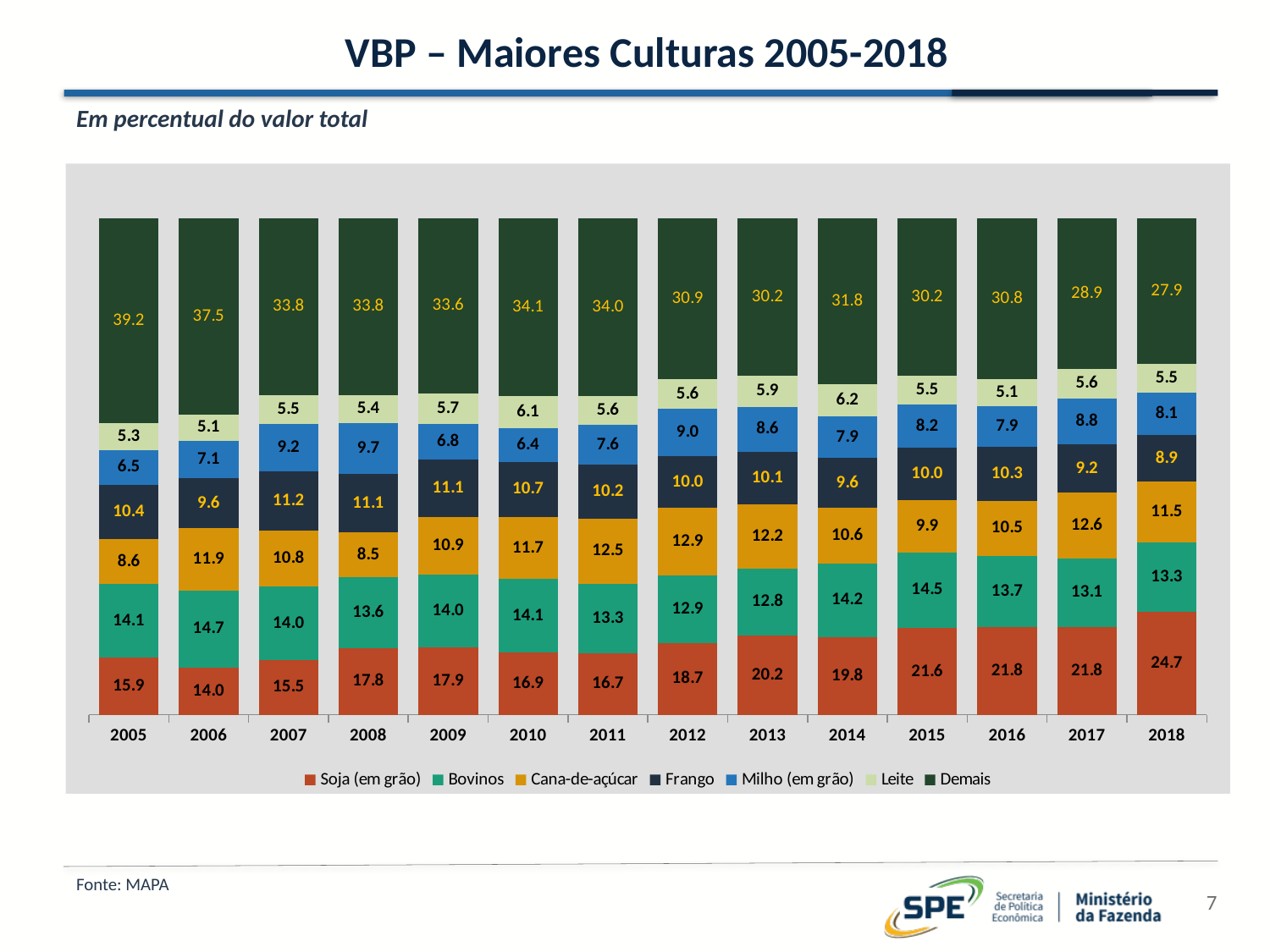
Which is larger, the Milho (em grão) value in 2008 or in 2009? 2008 How many years are shown on the x axis? 14 In which year is the Soja (em grão) value lowest? 2006 How many series does the legend list? 7 What is the total of the stacked bar for 2005? 100.0 Does the Demais value generally rise or fall from 2005 to 2018? Fall What is the value for Soja (em grão) in 2018? 24.7 What kind of chart is shown on the slide? Stacked bar chart In which year is the Soja (em grão) value highest? 2018 What is the value for Demais in 2005? 39.2 What is the value for Cana-de-açúcar in 2011? 12.5 What is the difference between the Soja (em grão) value in 2018 and in 2005? 8.8